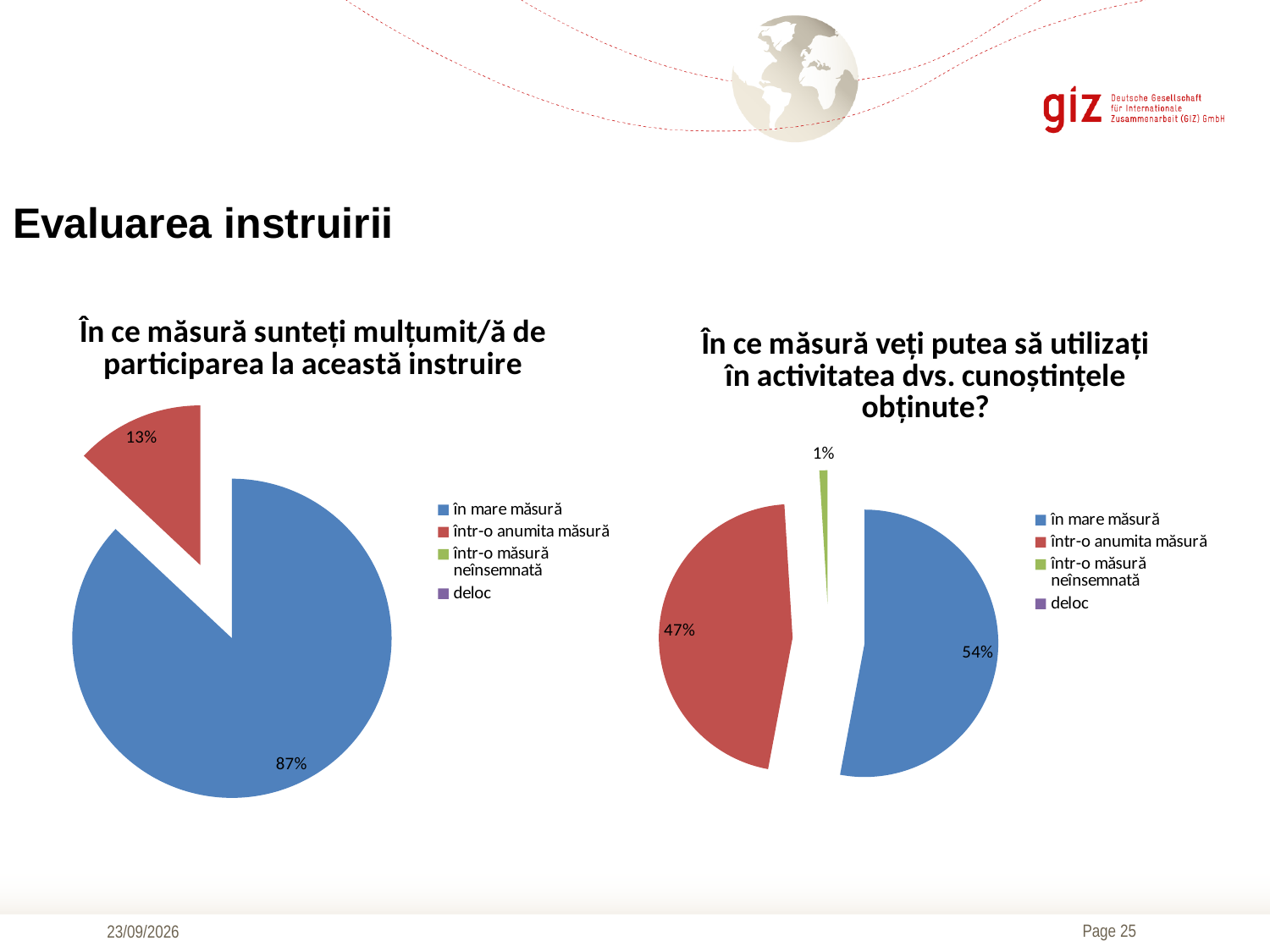
In the right chart, what share of respondents answered "în mare măsură"? 54% In the right chart, what share of respondents answered "într-o măsură neînsemnată"? 1% In the right chart, what share of respondents answered "într-o anumita măsură"? 47% In the left chart, which category has the largest slice? în mare măsură In the right chart, which category has the smallest visible slice? într-o măsură neînsemnată In the right chart, what is the difference between the "în mare măsură" and "într-o anumita măsură" shares? 7 percentage points What type of chart is used on the left side of the slide? Pie chart In the left chart, what is the difference between the "în mare măsură" and "într-o anumita măsură" shares? 74 percentage points In the right chart, which is larger: "în mare măsură" or "într-o anumita măsură"? în mare măsură How many entries does the legend of the right chart list? 4